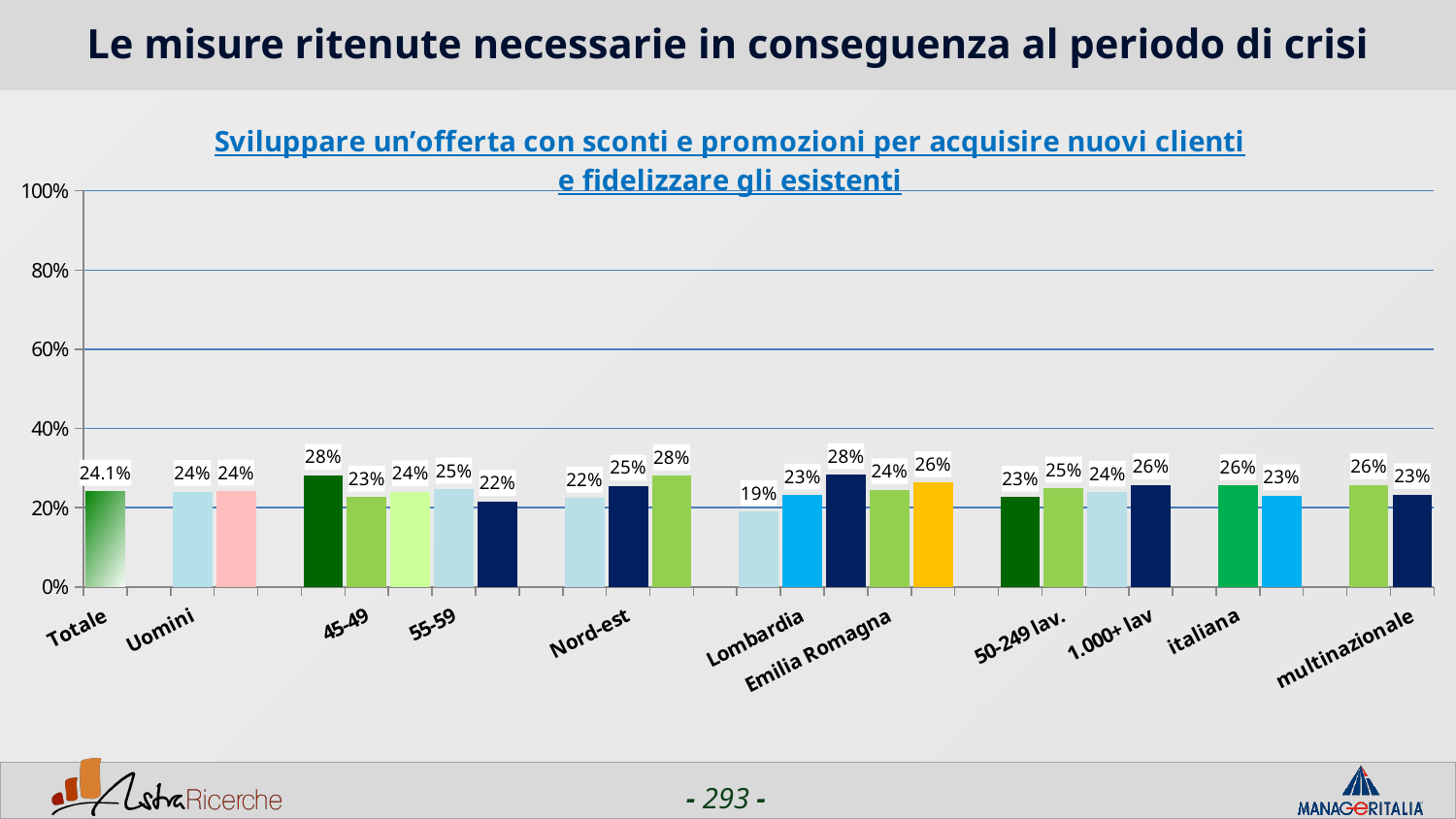
What is the value for multinazionale? 23% What is the difference between the values for italiana and multinazionale? 3% What is the value for Nord-est? 25% What is the value for Uomini? 24% What is the value for Totale? 24.1% What is the value for 45-49? 23% What is the value for 1.000+ lav? 26% What kind of chart is shown on the slide? bar chart What is the value for 55-59? 25% Is the value for Emilia Romagna greater or less than 40%? less What is the value for Lombardia? 23% Which is larger, the value for 1.000+ lav or the value for 50-249 lav.? 1.000+ lav